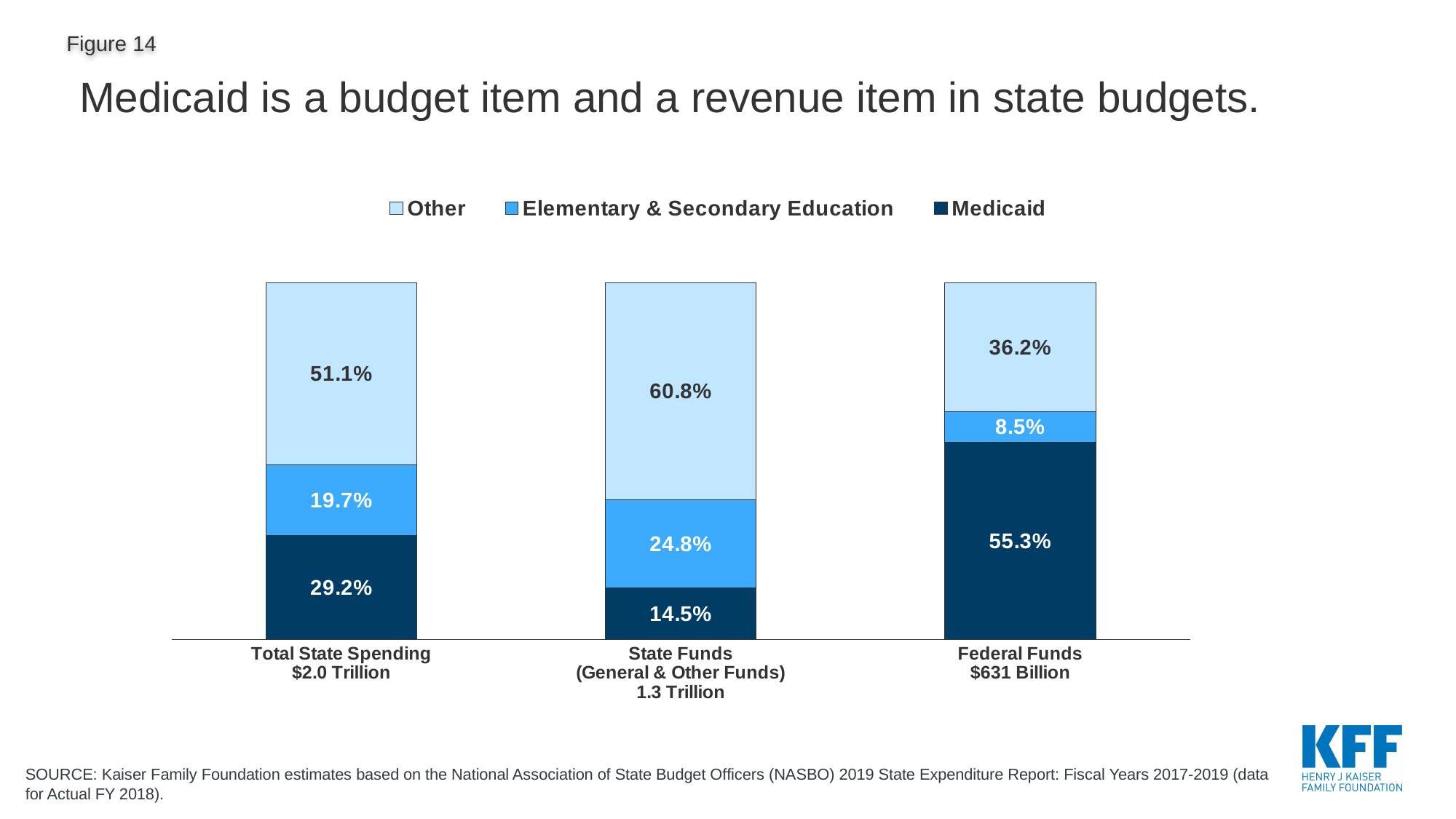
What is the Other share of Federal Funds? 36.2% How many bars are shown in the chart? 3 What is the Medicaid share of Federal Funds? 55.3% Which category has the highest Medicaid share? Federal Funds What is the Elementary & Secondary Education share of State Funds (General & Other Funds)? 24.8% What kind of chart is shown on the slide? Stacked bar chart Is the Other share larger for Total State Spending or for State Funds (General & Other Funds)? State Funds (General & Other Funds) What total dollar amount is shown under the Federal Funds bar? $631 Billion What is the Medicaid share of Total State Spending? 29.2% How many series does the legend list? 3 What is the difference between the Medicaid share of Federal Funds and the Medicaid share of State Funds (General & Other Funds)? 40.8% Which category has the lowest Elementary & Secondary Education share? Federal Funds